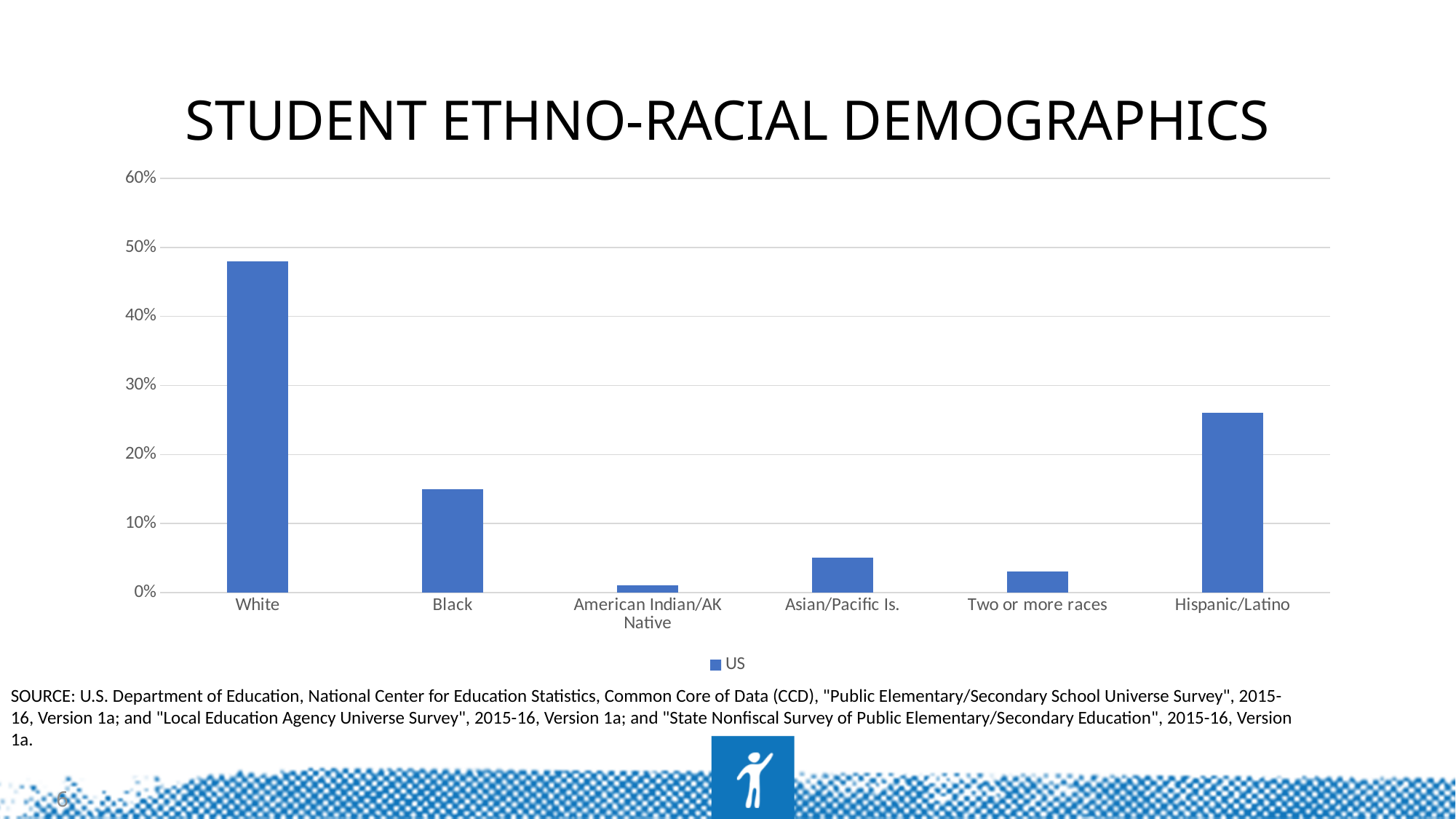
Which category has the lowest value? American Indian/AK Native Which is larger, the value for Asian/Pacific Is. or the value for Two or more races? Asian/Pacific Is. Is the value for Black greater or less than 20%? less How many series does the legend list? 1 Is the value for Asian/Pacific Is. greater or less than 10%? less Is the value for White greater or less than 40%? greater Which category has the highest value? White What type of chart is shown on the slide? bar chart What is the title of the chart? STUDENT ETHNO-RACIAL DEMOGRAPHICS Which is larger, the value for Black or the value for Hispanic/Latino? Hispanic/Latino How many categories are shown on the x axis? 6